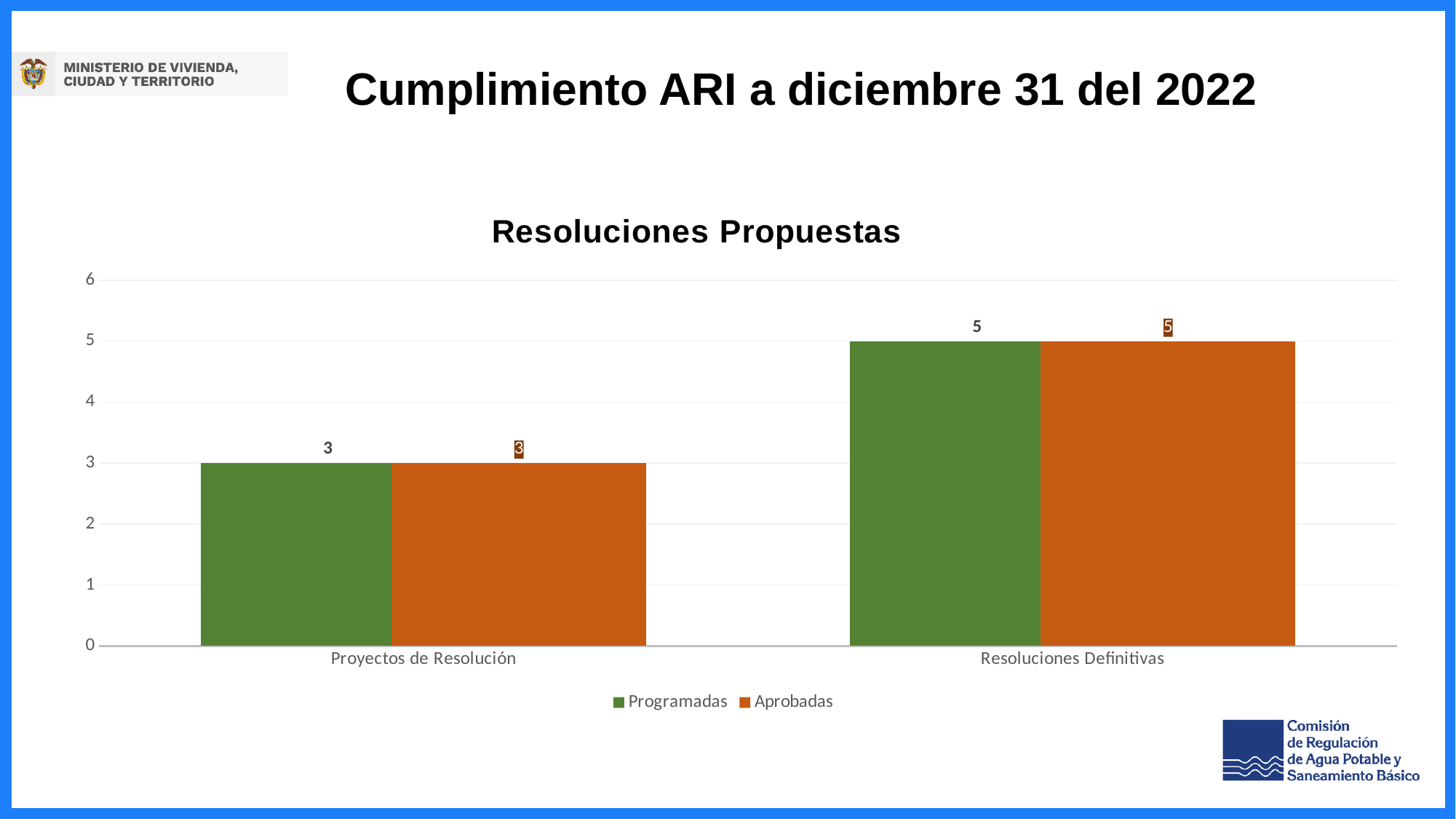
Which category has the lowest Aprobadas value? Proyectos de Resolución How many series does the legend list? 2 Which category has the highest Programadas value? Resoluciones Definitivas How many categories are shown on the x axis? 2 What is the value of Programadas for Proyectos de Resolución? 3 Is the Programadas value for Resoluciones Definitivas greater or less than 4? greater What is the title of the chart? Resoluciones Propuestas Which is larger: Aprobadas for Resoluciones Definitivas or Aprobadas for Proyectos de Resolución? Resoluciones Definitivas What is the difference between the Programadas values for Resoluciones Definitivas and Proyectos de Resolución? 2 What kind of chart is shown on the slide? bar chart What is the value of Aprobadas for Proyectos de Resolución? 3 What is the value of Aprobadas for Resoluciones Definitivas? 5